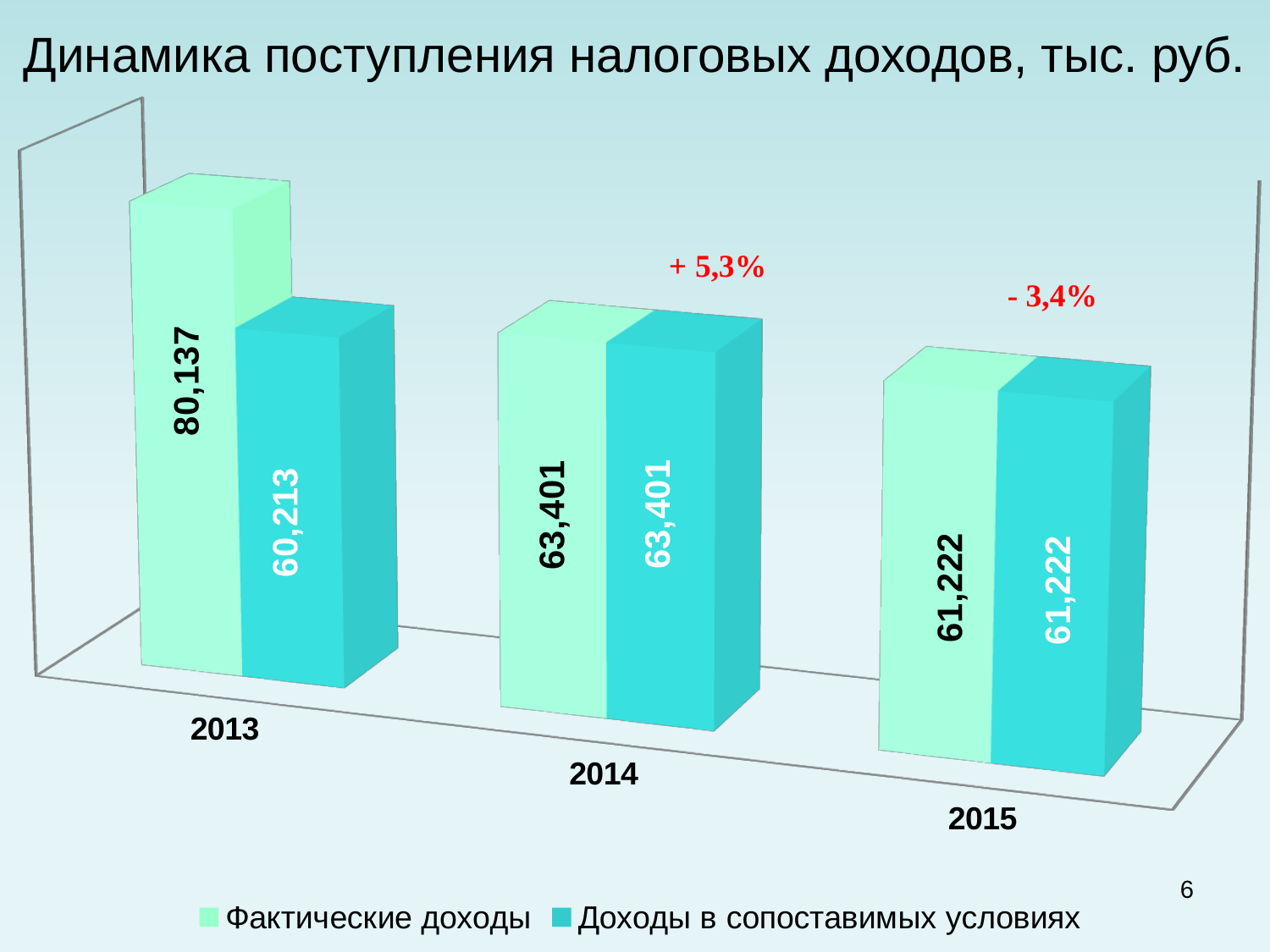
What is the value of Доходы в сопоставимых условиях for 2013? 60,213 What is the value of Фактические доходы for 2014? 63,401 In which year is Фактические доходы the highest? 2013 How many series does the legend list? 2 What is the value of Доходы в сопоставимых условиях for 2015? 61,222 What is the value of Фактические доходы for 2013? 80,137 What is the difference between Фактические доходы and Доходы в сопоставимых условиях in 2013? 19,924 Which is larger: Фактические доходы in 2014 or Фактические доходы in 2015? 2014 In which year is Доходы в сопоставимых условиях the lowest? 2013 What is the difference between Доходы в сопоставимых условиях in 2014 and in 2015? 2,179 What kind of chart is shown on the slide? Bar chart How many years are shown on the x axis? 3